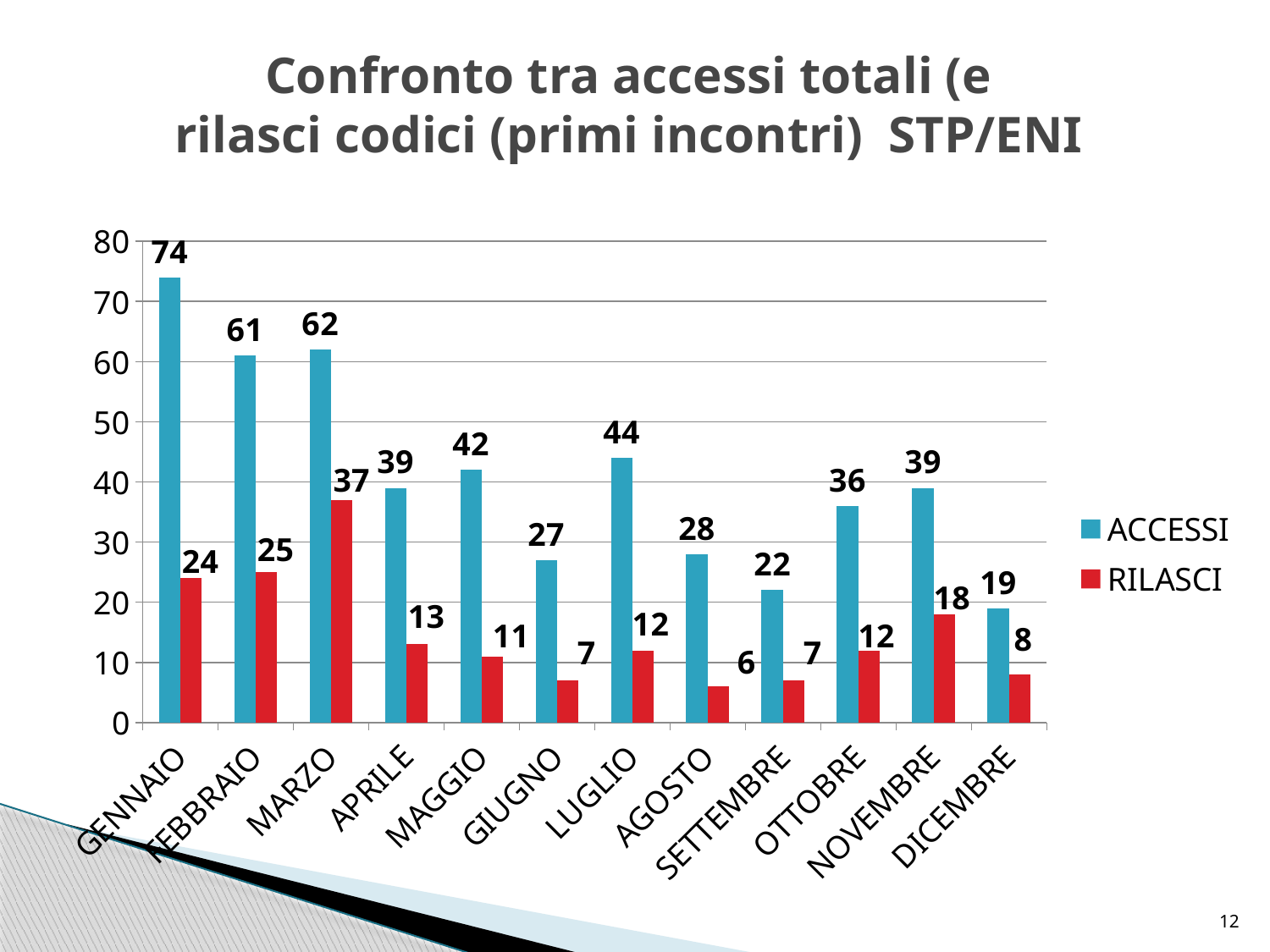
What is the ACCESSI value for LUGLIO? 44 Which colour represents the RILASCI series? Red How many series does the legend list? 2 What is the difference between ACCESSI and RILASCI for GENNAIO? 50 What kind of chart is shown on the slide? Bar chart Which month has the highest ACCESSI value? GENNAIO What is the RILASCI value for MARZO? 37 Which month has the lowest RILASCI value? AGOSTO Which is larger, the ACCESSI value for MAGGIO or the ACCESSI value for OTTOBRE? MAGGIO What is the RILASCI value for NOVEMBRE? 18 What is the ACCESSI value for GENNAIO? 74 How many months are shown on the x axis? 12